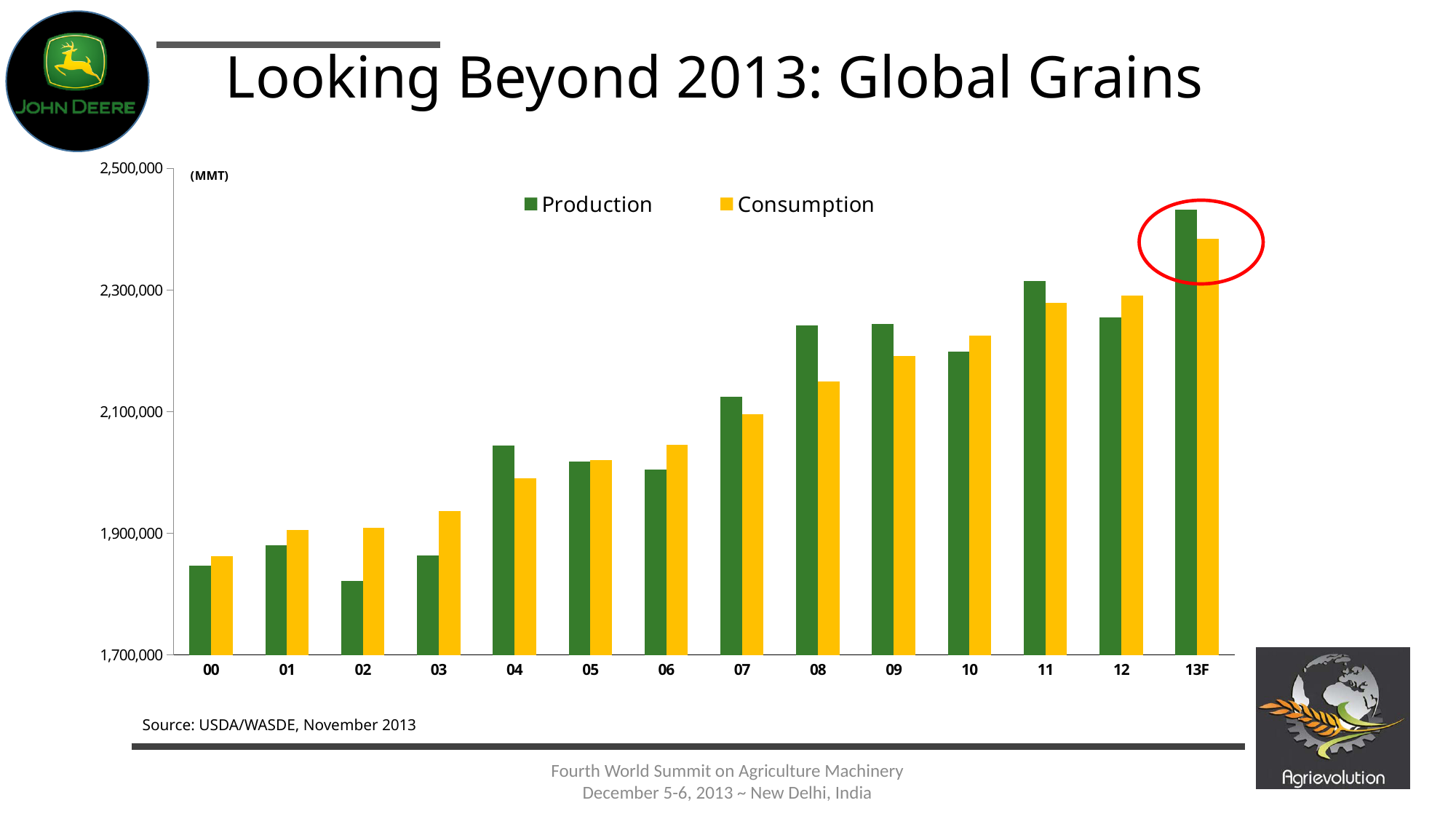
Is the Production value for 02 greater or less than 1,900,000? less How many series does the legend list? 2 Is the Consumption value for 08 greater or less than 2,100,000? greater In which year is Production lowest? 02 What kind of chart is shown on the slide? bar chart Do the Production values generally rise or fall from 00 to 13F? rise In which year is Production highest? 13F Is the Production value for 13F greater or less than 2,300,000? greater In which year is Consumption lowest? 00 How many year categories are shown on the x axis? 14 In 02, which is larger, Production or Consumption? Consumption In 13F, which is larger, Production or Consumption? Production